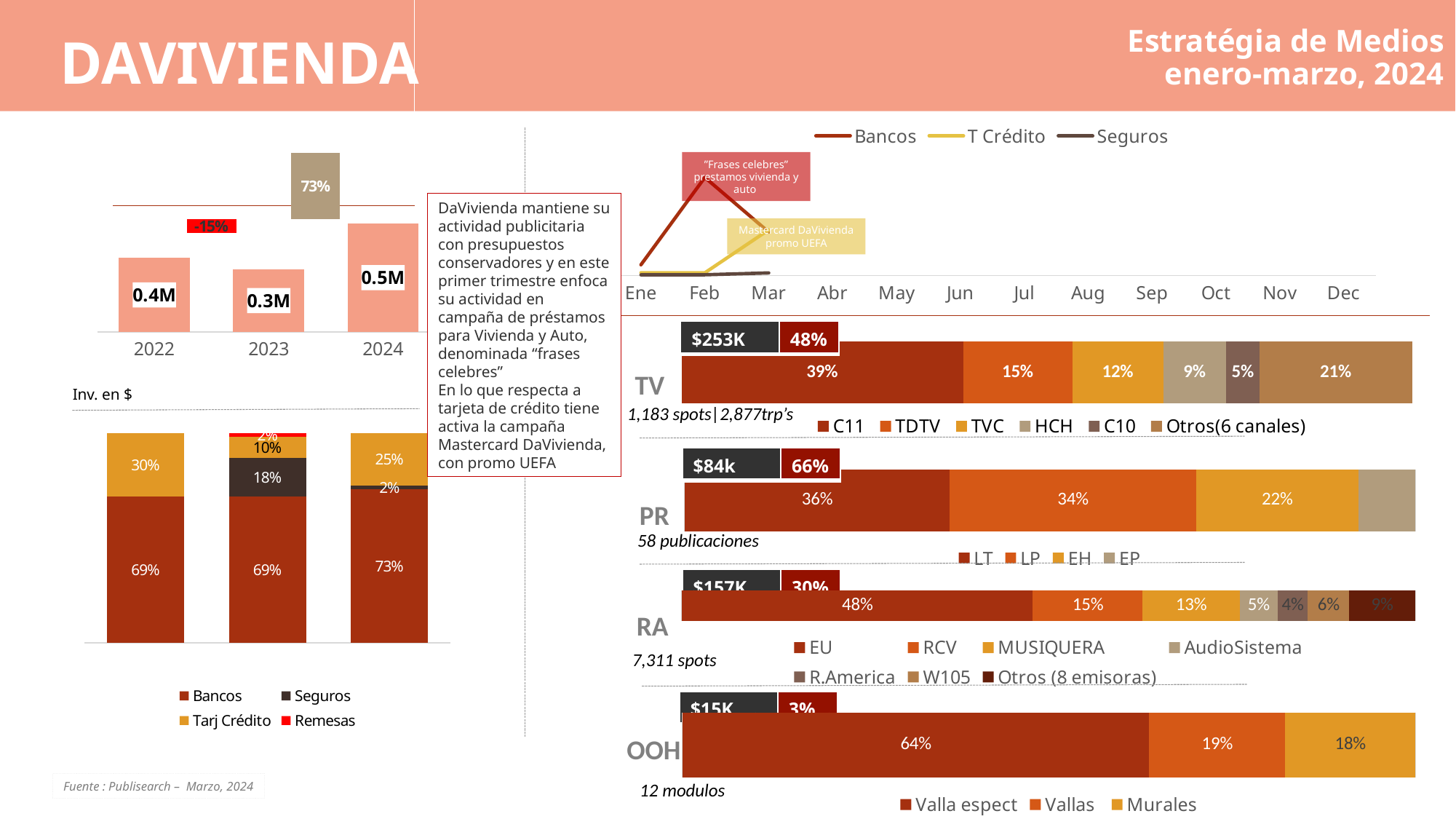
In the 'Inv. en $' stacked bar chart, what share does Seguros have in 2023? 18% How many series does the legend of the 'Inv. en $' stacked bar chart list? 4 In the OOH stacked bar, is the share for Valla espect larger or smaller than the share for Vallas? larger In the top-left bar chart of yearly investment, what percentage change is shown between 2023 and 2024? 73% In the top-left bar chart of yearly investment, what is the value for 2024? 0.5M In the PR stacked bar, what share does EH have? 22% In the RA stacked bar, which station has the largest share? EU In the TV stacked bar, what share does C11 have? 39% In the 'Inv. en $' stacked bar chart, what is the difference between the Tarj Crédito share in 2022 and in 2024? 5% In the 'Inv. en $' stacked bar chart, what share does Bancos have in 2024? 73% In the TV stacked bar, which channel has the smallest share? C10 In the top-left bar chart of yearly investment, which year has the lowest value? 2023